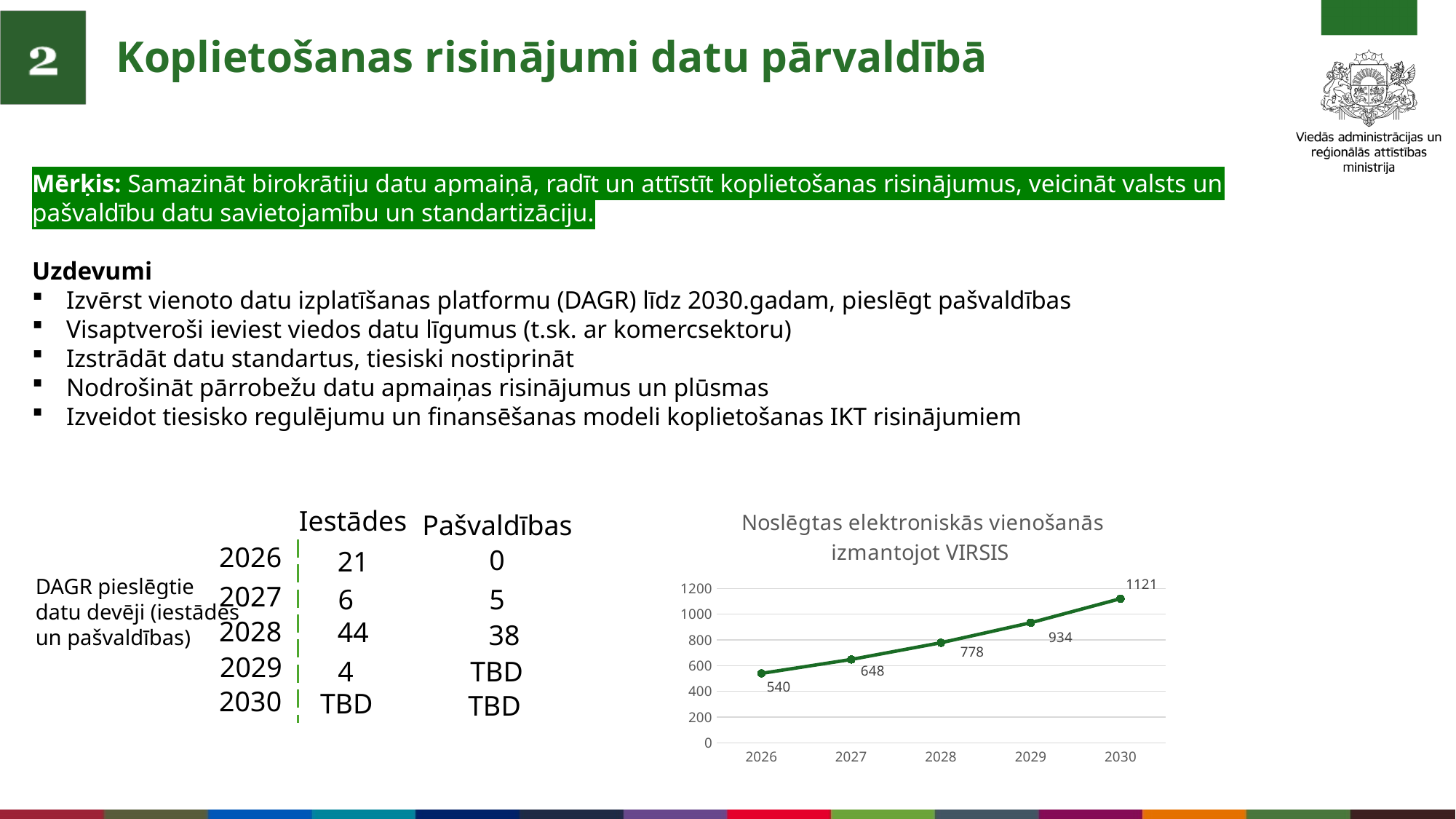
How many years are plotted in the chart "Noslēgtas elektroniskās vienošanās izmantojot VIRSIS"? 5 In the chart "Noslēgtas elektroniskās vienošanās izmantojot VIRSIS", is the value for 2029 greater or less than 1000? less In the chart "Noslēgtas elektroniskās vienošanās izmantojot VIRSIS", what is the difference between the values for 2029 and 2028? 156 In the chart "Noslēgtas elektroniskās vienošanās izmantojot VIRSIS", what is the value for 2028? 778 In the chart "Noslēgtas elektroniskās vienošanās izmantojot VIRSIS", which year has the highest value? 2030 In the chart "Noslēgtas elektroniskās vienošanās izmantojot VIRSIS", which year has the lowest value? 2026 In the chart "Noslēgtas elektroniskās vienošanās izmantojot VIRSIS", what is the value for 2026? 540 What type of chart is "Noslēgtas elektroniskās vienošanās izmantojot VIRSIS"? line chart In the chart "Noslēgtas elektroniskās vienošanās izmantojot VIRSIS", what is the value for 2030? 1121 In the chart "Noslēgtas elektroniskās vienošanās izmantojot VIRSIS", what is the difference between the values for 2030 and 2026? 581 In the chart "Noslēgtas elektroniskās vienošanās izmantojot VIRSIS", do the values rise or fall from 2026 to 2030? rise In the chart "Noslēgtas elektroniskās vienošanās izmantojot VIRSIS", which is larger, the value for 2027 or the value for 2029? 2029